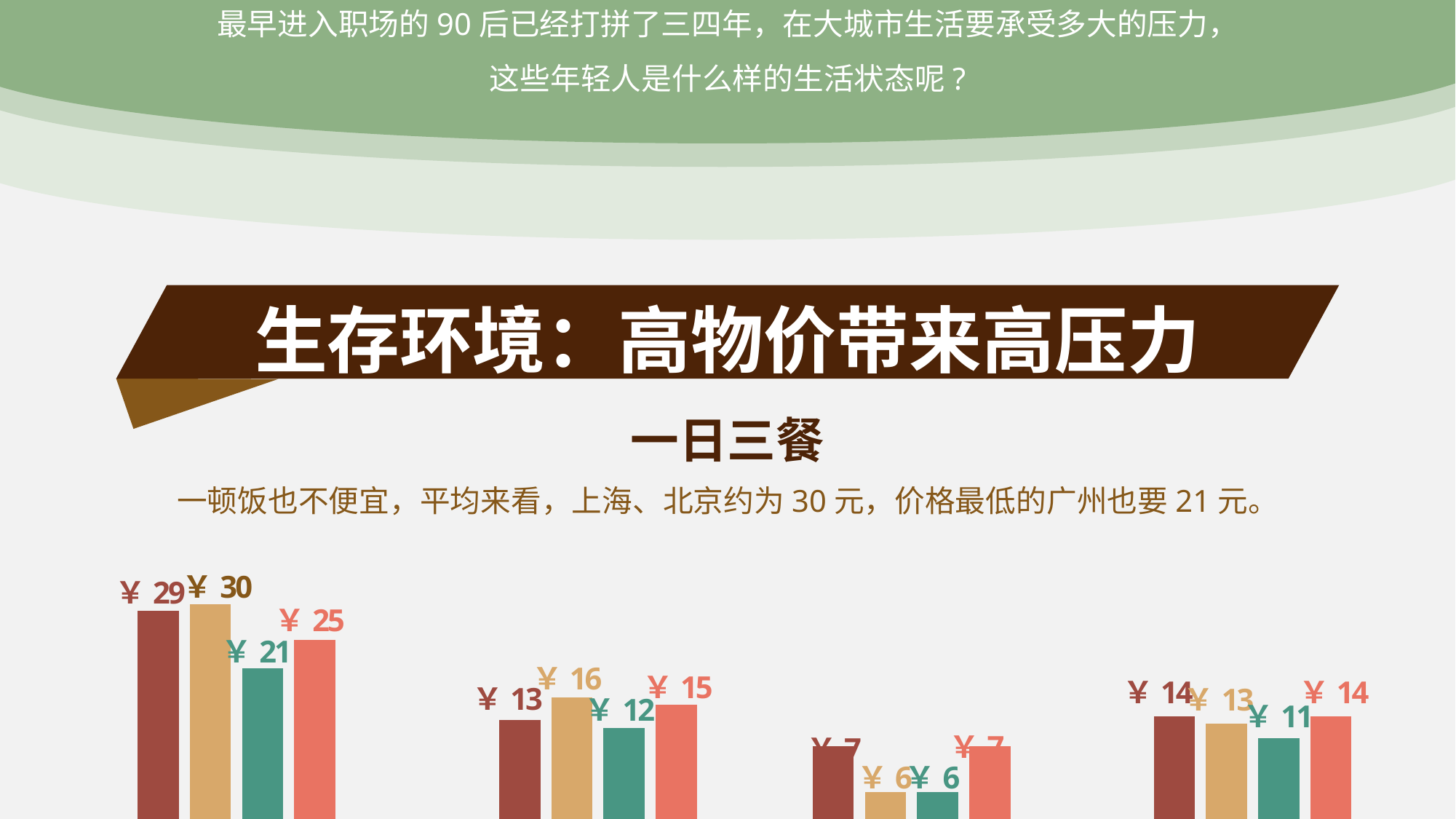
What is the title shown above the chart? 一日三餐 In the leftmost group of bars, which bar has the lowest value? The teal (third) bar, ¥ 21 In the leftmost group of bars, what value is printed above the tan (second) bar? ¥ 30 What kind of chart is shown on the slide? Bar chart In the leftmost group of bars, what is the difference between the tan bar (¥ 30) and the teal bar (¥ 21)? ¥ 9 In the leftmost group of bars, which bar has the highest value? The tan (second) bar, ¥ 30 In the third group of bars from the left, what value is printed above the dark red (first) bar? ¥ 7 In the second group of bars from the left, what value is printed above the tan bar? ¥ 16 How many bars are in each group on the chart? 4 In the leftmost group of bars, what value is printed above the teal (third) bar? ¥ 21 In the rightmost group of bars, which is larger: the dark red bar or the teal bar? The dark red bar (¥ 14) In the second group of bars from the left, which bar has the lowest value? The teal (third) bar, ¥ 12